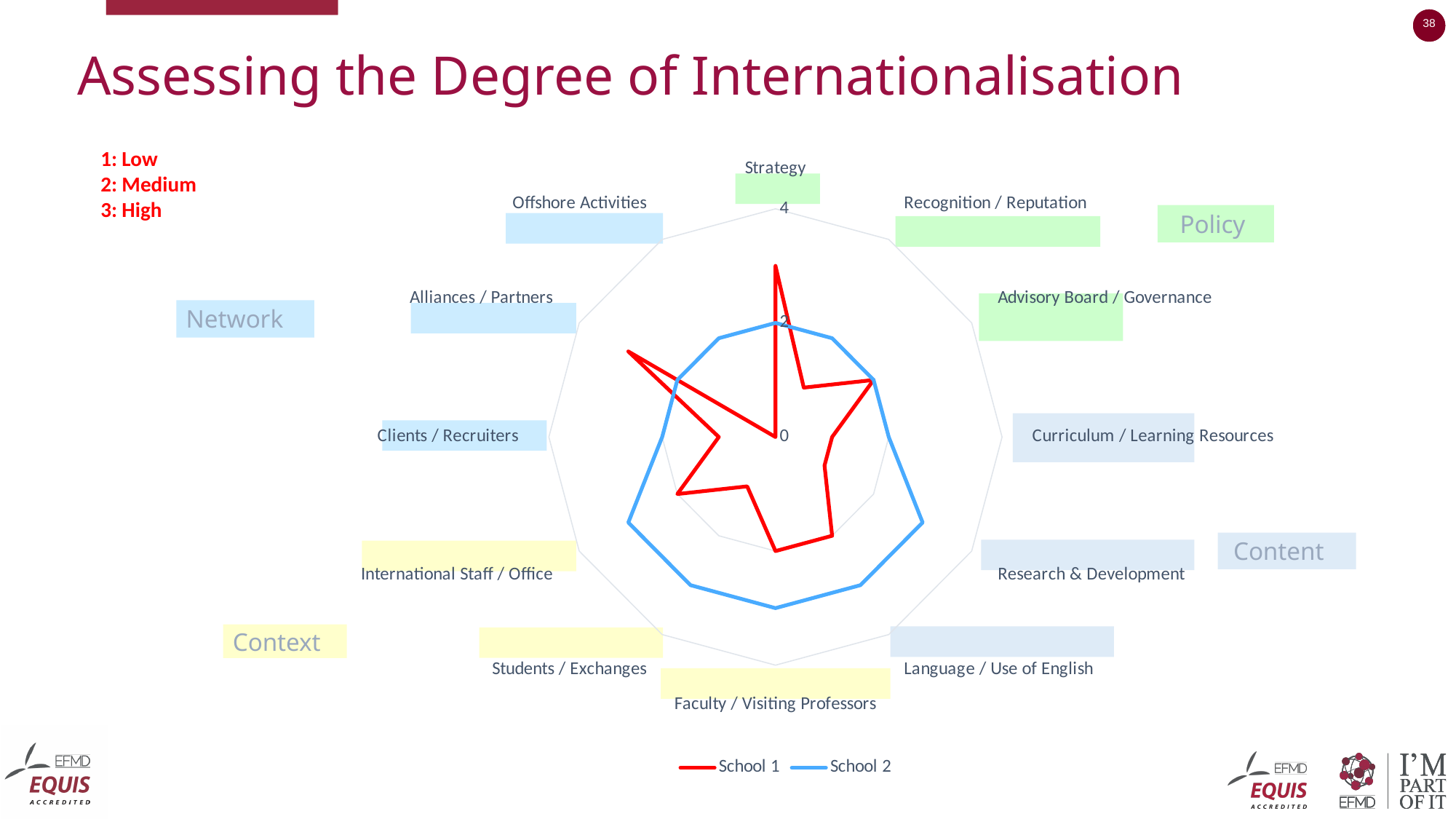
What kind of chart is shown on the slide? Radar chart Is the value for School 1 on the Clients / Recruiters axis greater or less than 2? less How many categories (axes) does the radar chart have? 12 On the Strategy axis, which school has the higher value, School 1 or School 2? School 1 What is the maximum value shown on the chart's axis scale? 4 On the Research & Development axis, which school has the higher value, School 1 or School 2? School 2 Which two series are listed in the chart legend? School 1 and School 2 Is the value for School 1 on the Strategy axis greater or less than 2? greater What is the value for School 2 on the Strategy axis? 2 Is the value for School 2 on the Research & Development axis greater or less than 2? greater How many series does the chart legend list? 2 On the Alliances / Partners axis, which school has the higher value, School 1 or School 2? School 1